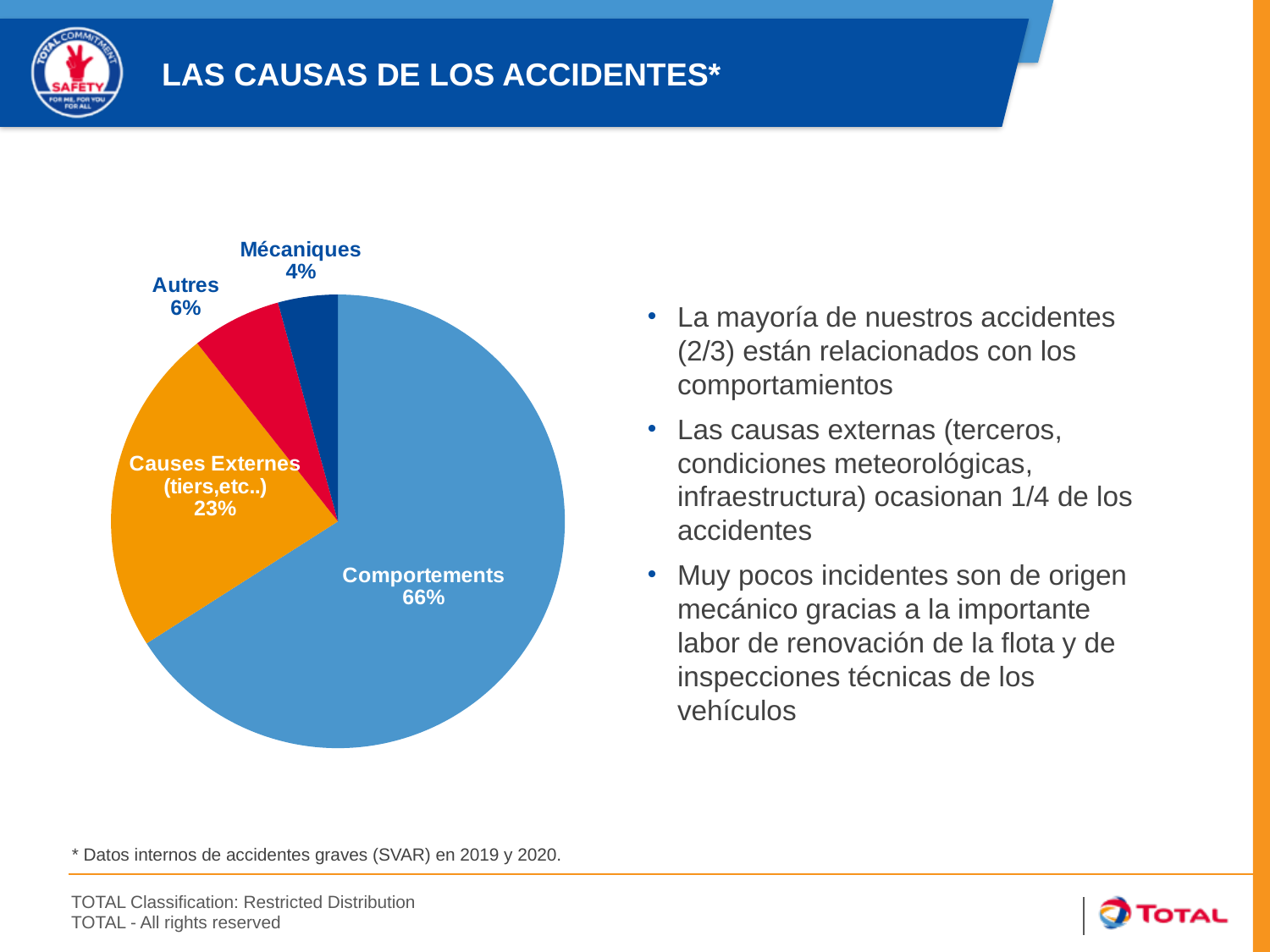
What kind of chart is shown on the slide? Pie chart How many categories are shown in the pie chart? 4 Which category has the largest slice of the pie? Comportements What colour is the Comportements slice? Light blue What share of accidents is attributed to Autres? 6% What share of accidents is attributed to Comportements? 66% What is the difference in percentage points between Comportements and Causes Externes? 43 Which category has the smallest slice of the pie? Mécaniques Which is larger, the share for Autres or the share for Mécaniques? Autres What is the combined share of Autres and Mécaniques? 10% What share of accidents is attributed to Mécaniques? 4% What share of accidents is attributed to Causes Externes (tiers, etc..)? 23%